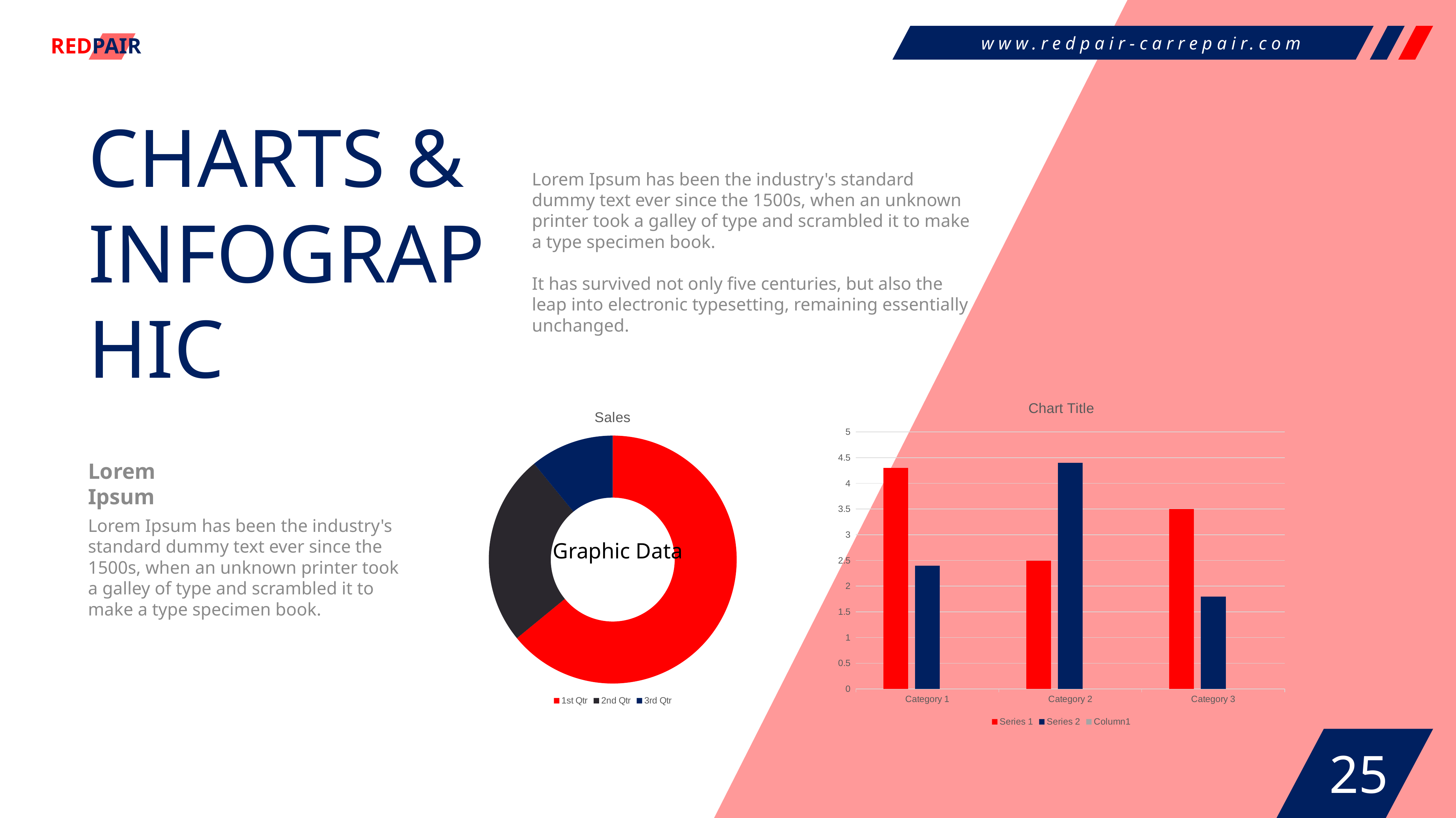
What type of chart is the chart titled "Sales"? Doughnut chart What type of chart is the chart titled "Chart Title"? Bar chart In the chart titled "Chart Title", is the Series 1 value for Category 1 greater or less than 4? greater In the "Sales" chart, which quarter has the largest slice? 1st Qtr In the "Sales" chart, which quarter has the smallest slice? 3rd Qtr How many slices does the "Sales" doughnut chart have? 3 In the chart titled "Chart Title", is the Series 2 value for Category 2 greater or less than 4? greater In the chart titled "Chart Title", which category has the highest Series 1 value? Category 1 In the chart titled "Chart Title", is the Series 2 value for Category 3 greater or less than 2? less How many series does the legend of the chart titled "Chart Title" list? 3 In the chart titled "Chart Title", for Category 2, which is larger: Series 1 or Series 2? Series 2 In the chart titled "Chart Title", which category has the lowest Series 2 value? Category 3